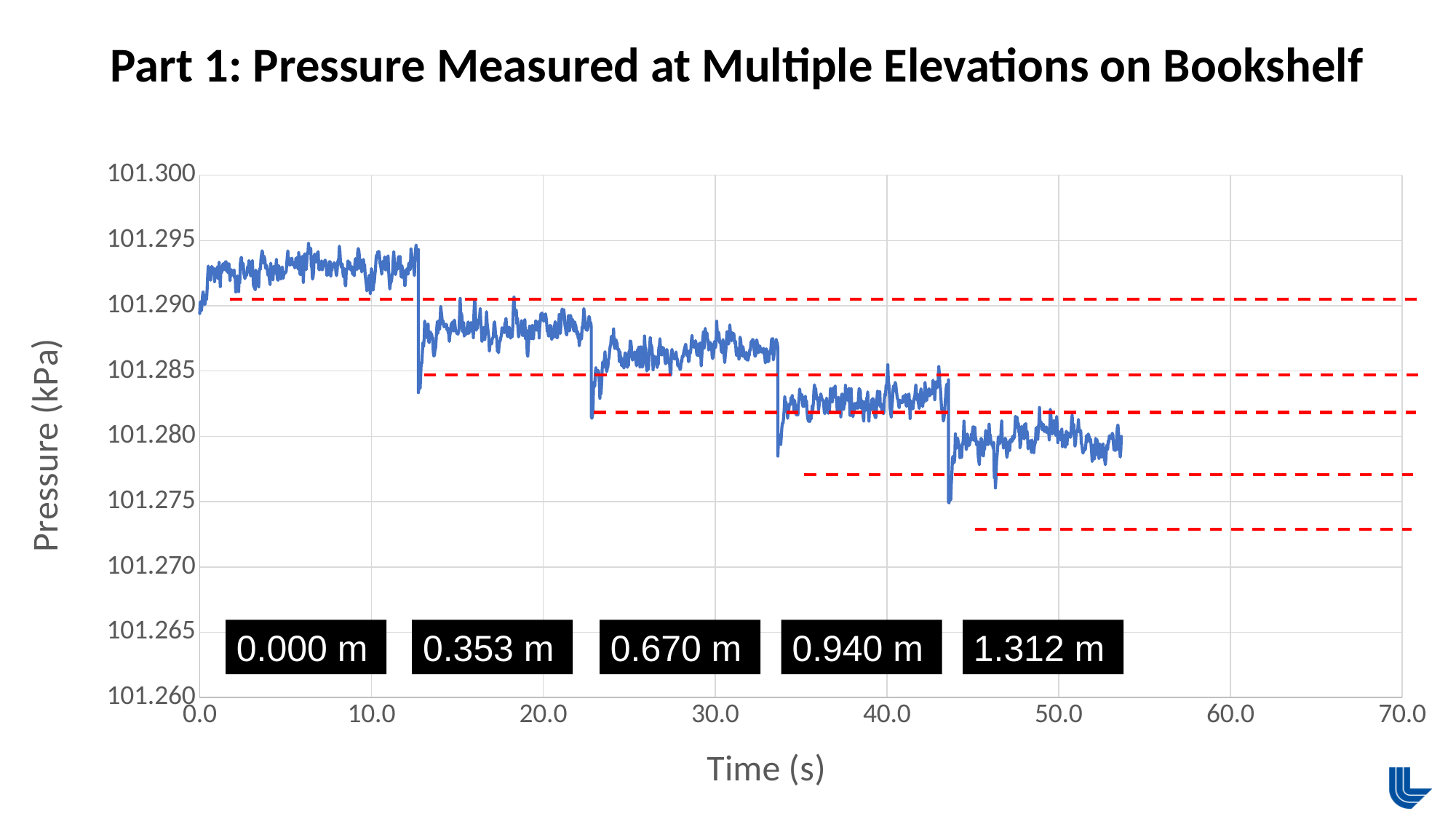
Is the pressure measured at 1.312 m greater or less than 101.285 kPa? less Which elevation has the higher measured pressure, 0.670 m or 0.940 m? 0.670 m What kind of chart is shown on the slide? line chart How many elevation labels are shown on the chart? 5 What is the title of the chart? Part 1: Pressure Measured at Multiple Elevations on Bookshelf Is the pressure measured at 0.940 m greater or less than 101.280 kPa? greater At which elevation is the measured pressure lowest? 1.312 m Does the pressure rise or fall as time increases along the x axis? fall At which elevation is the measured pressure highest? 0.000 m What is the label of the y axis? Pressure (kPa) Is the pressure measured at 0.353 m greater or less than 101.290 kPa? less